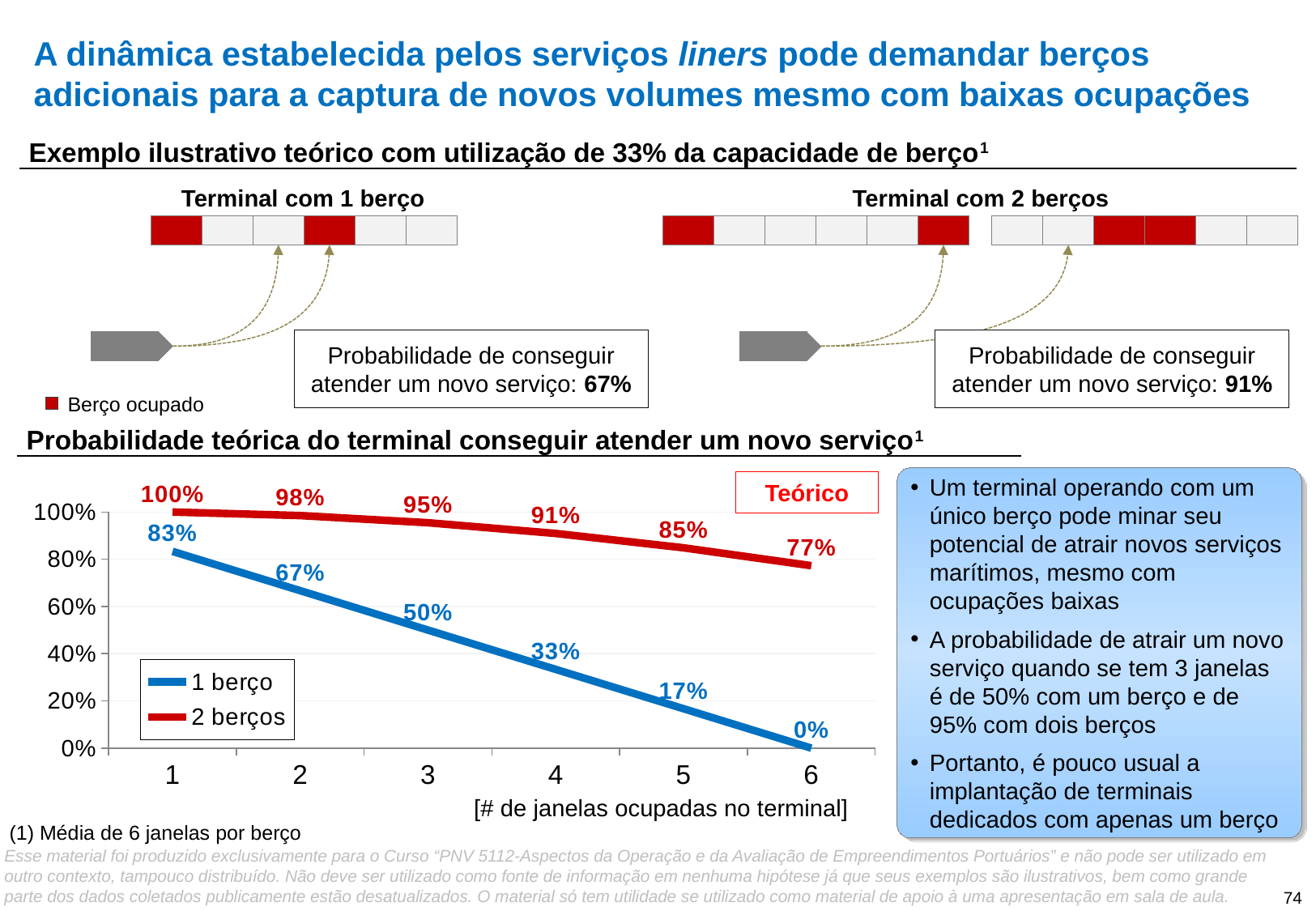
Which series has the higher value at 2 janelas ocupadas, '1 berço' or '2 berços'? 2 berços What is the value for '1 berço' at 3 janelas ocupadas? 50% How many points are plotted along the x axis for each series? 6 What is the difference between the '2 berços' and '1 berço' values at 5 janelas ocupadas? 68% Do the values of the '1 berço' series rise or fall as the number of janelas ocupadas increases? fall What is the value for '2 berços' at 4 janelas ocupadas? 91% What type of chart is shown under 'Probabilidade teórica do terminal conseguir atender um novo serviço'? line chart How many series does the legend of the line chart list? 2 At which number of janelas ocupadas is the '2 berços' series lowest? 6 What is the value for '2 berços' at 1 janela ocupada? 100% What is the x-axis label of the line chart? [# de janelas ocupadas no terminal] What is the value for '1 berço' at 6 janelas ocupadas? 0%